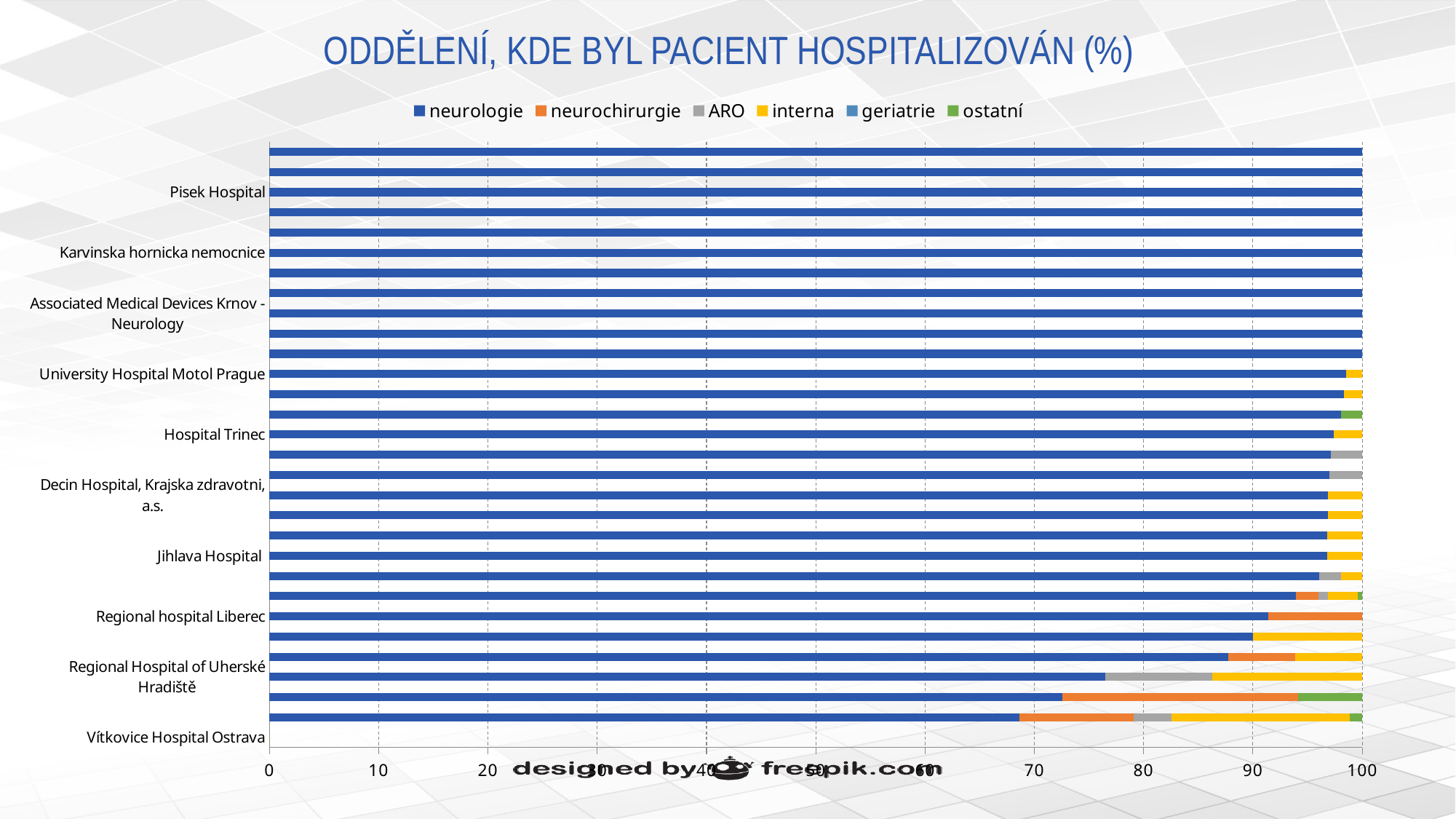
Which colour represents the 'interna' series in the legend? yellow Which hospital has the lowest neurologie share? Vítkovice Hospital Ostrava Is the neurologie value for Pisek Hospital greater or less than 90? greater What kind of chart is shown on the slide? bar chart What is the title of the chart? ODDĚLENÍ, KDE BYL PACIENT HOSPITALIZOVÁN (%) Is the neurologie value for Regional hospital Liberec greater or less than 90? greater Is the neurologie value for Jihlava Hospital greater or less than 90? greater How many series does the legend list? 6 Which has a larger neurologie share, Pisek Hospital or Vítkovice Hospital Ostrava? Pisek Hospital Which has a larger neurologie share, Regional hospital Liberec or Regional Hospital of Uherské Hradiště? Regional hospital Liberec